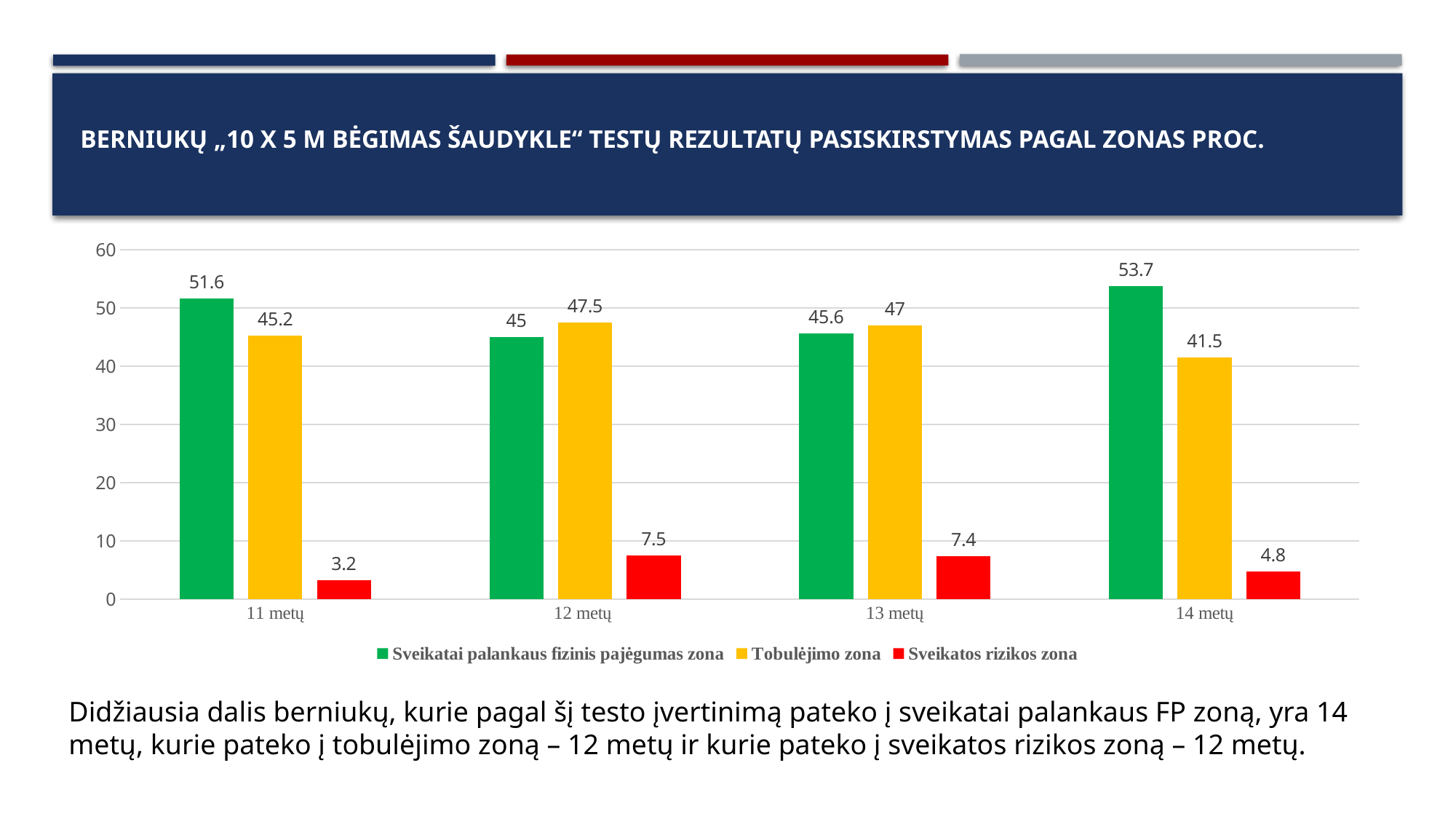
What is the value for "Sveikatos rizikos zona" at 14 metų? 4.8 How many age groups are shown on the x axis? 4 How many series does the legend list? 3 What is the total of the three values at 12 metų? 100 Which age group has the lowest value for "Sveikatos rizikos zona"? 11 metų At 13 metų, which is larger: "Sveikatai palankaus fizinis pajėgumas zona" or "Tobulėjimo zona"? Tobulėjimo zona What is the difference between the "Tobulėjimo zona" values at 12 metų and 14 metų? 6 What is the value for "Sveikatai palankaus fizinis pajėgumas zona" at 11 metų? 51.6 What colour represents "Sveikatos rizikos zona" in the chart? Red What is the value for "Tobulėjimo zona" at 12 metų? 47.5 What kind of chart is shown on the slide? Bar chart Which age group has the highest value for "Sveikatai palankaus fizinis pajėgumas zona"? 14 metų